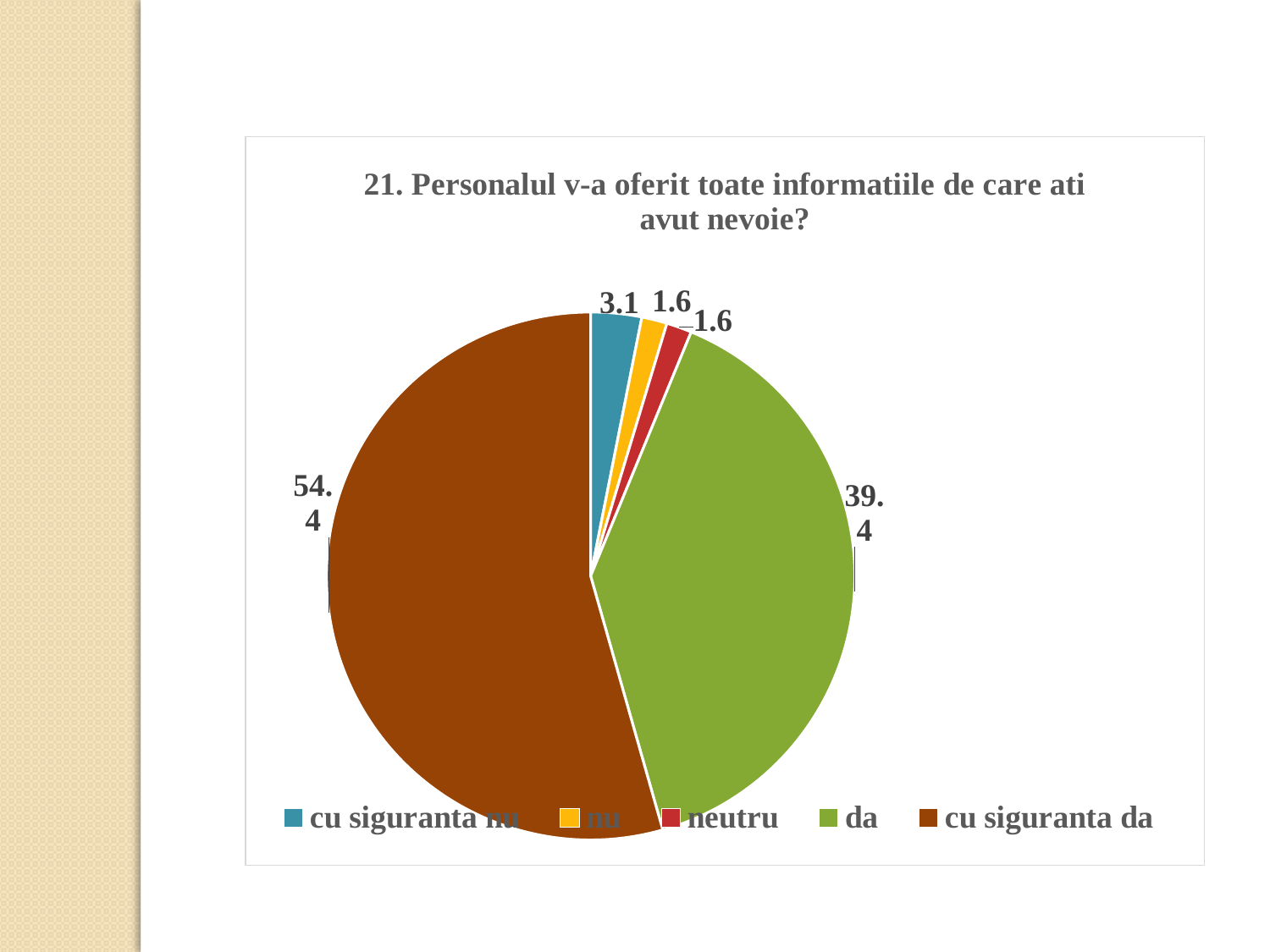
What colour is the slice for "da"? green What kind of chart is shown on the slide? pie chart What is the value for "nu"? 1.6 What is the value for "neutru"? 1.6 What is the value for "cu siguranta da"? 54.4 Which category has the largest slice of the pie? cu siguranta da What is the value for "da"? 39.4 What is the value for "cu siguranta nu"? 3.1 How many categories does the pie chart have? 5 Which is larger, the value for "cu siguranta nu" or the value for "neutru"? cu siguranta nu What is the difference between the values for "cu siguranta da" and "da"? 15.0 What is the title of the chart? 21. Personalul v-a oferit toate informatiile de care ati avut nevoie?